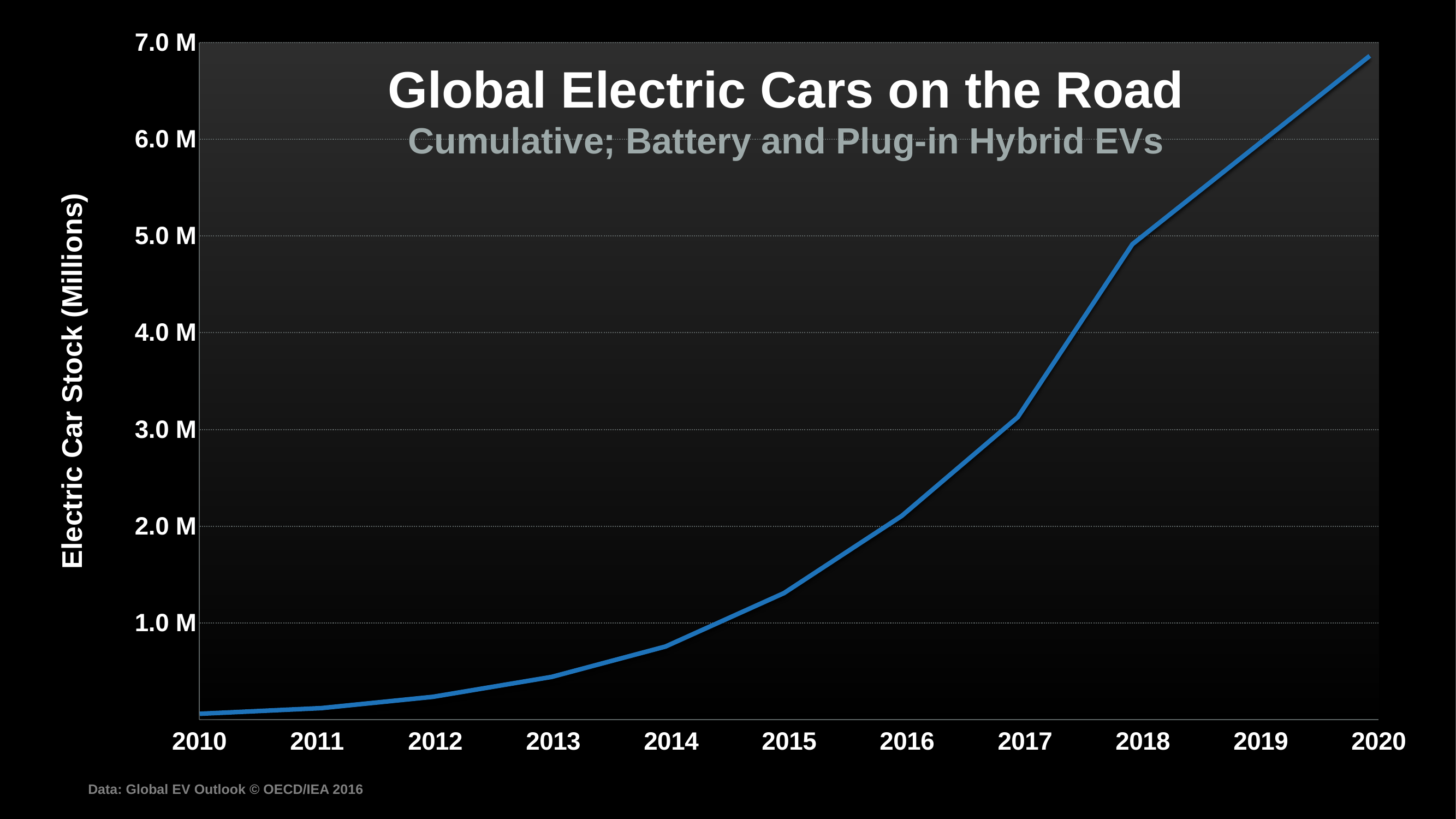
Is the value for 2016 greater or less than 3.0 M? less Is the value for 2015 greater or less than 1.0 M? greater Which year has the lowest electric car stock? 2010 Which year has the highest electric car stock? 2020 Is the value for 2020 greater or less than 6.0 M? greater What is the label on the vertical axis? Electric Car Stock (Millions) Which is larger, the value for 2018 or the value for 2016? 2018 What kind of chart is shown on the slide? line chart Do the values rise or fall from 2010 to 2020? rise How many years are shown along the x axis? 11 What is the title of the chart? Global Electric Cars on the Road